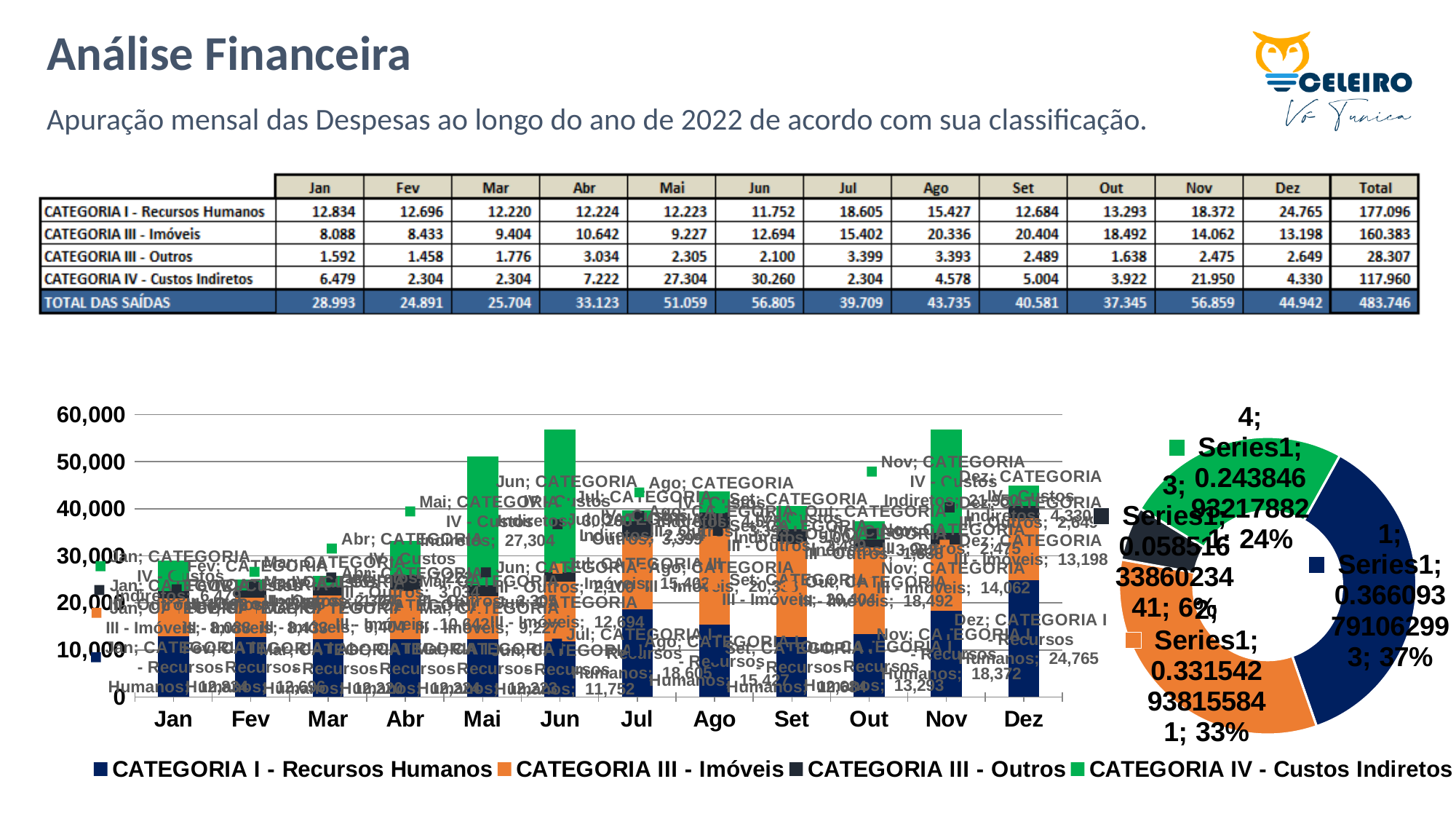
In the bar chart, what is the value for CATEGORIA IV - Custos Indiretos in Mai? 27,304 How many series does the bar chart's legend list? 4 In the doughnut chart on the right, what share does slice 1 represent? 37% In the bar chart, is the total stacked bar for Jun greater or less than 50,000? greater In the bar chart, what is the value for CATEGORIA I - Recursos Humanos in Dez? 24,765 What kind of chart is the chart on the left of the slide? bar chart In the bar chart, is the total stacked bar for Jan greater or less than 30,000? less In the doughnut chart on the right, which slice has the smallest share? 3 In the bar chart, how many months are shown on the x axis? 12 In the bar chart, which is larger: CATEGORIA I - Recursos Humanos in Dez or in Nov? Dez In the bar chart, what is the value for CATEGORIA IV - Custos Indiretos in Nov? 21,950 In the bar chart, what is the value for CATEGORIA III - Imóveis in Nov? 14,062